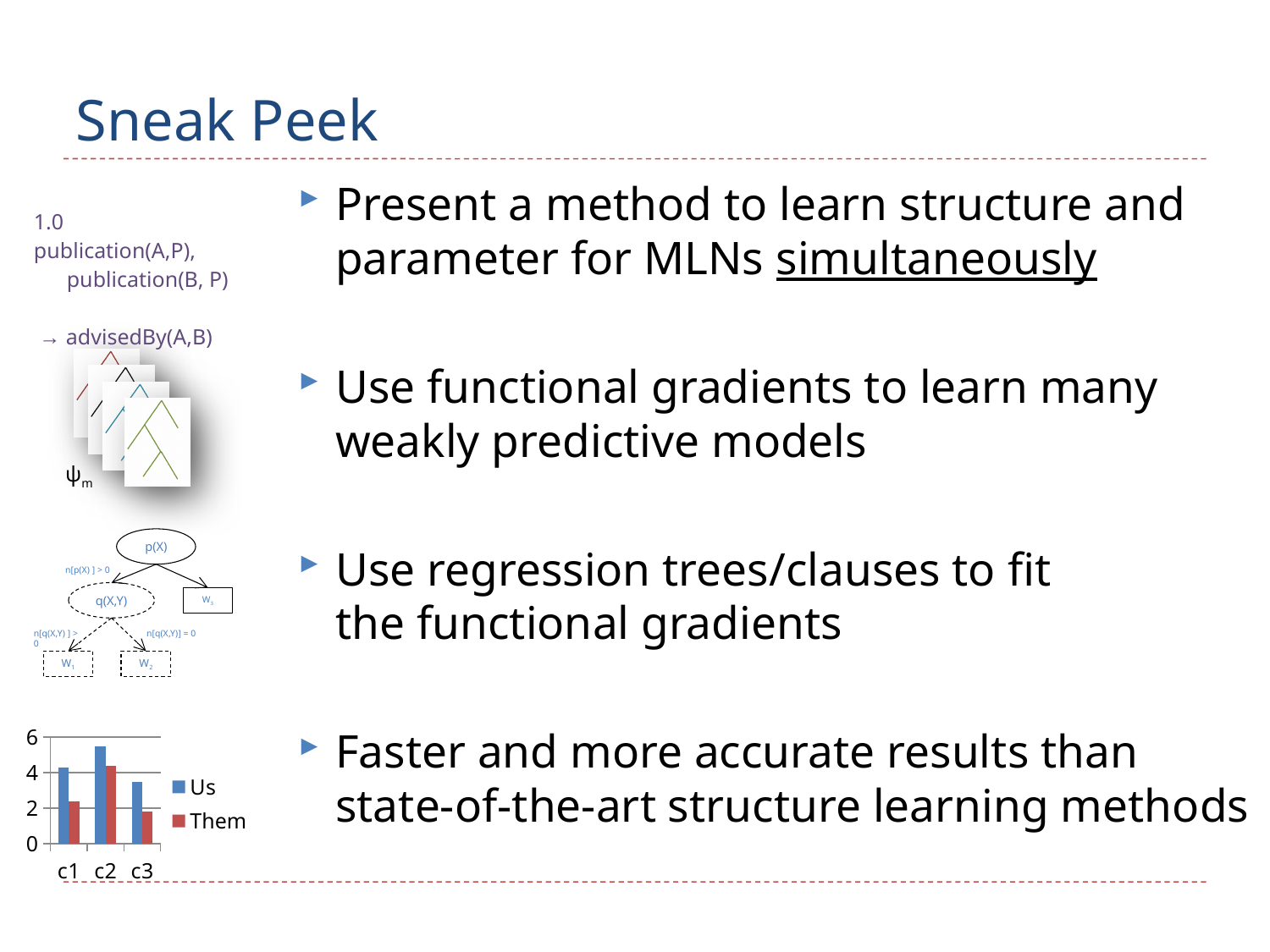
Which category has the lowest value for the Them series in the bar chart? c3 Which category has the highest value for the Them series in the bar chart? c2 In the bar chart, which is larger for c1: the Us value or the Them value? Us How many series does the legend of the bar chart list? 2 What kind of chart is shown at the bottom left of the slide? bar chart Which category has the highest value for the Us series in the bar chart? c2 How many categories are shown on the x axis of the bar chart? 3 What colour represents the Them series in the bar chart? red In the bar chart, is the value for Us at c3 greater or less than 4? less Which category has the lowest value for the Us series in the bar chart? c3 In the bar chart, is the value for Us at c2 greater or less than 4? greater